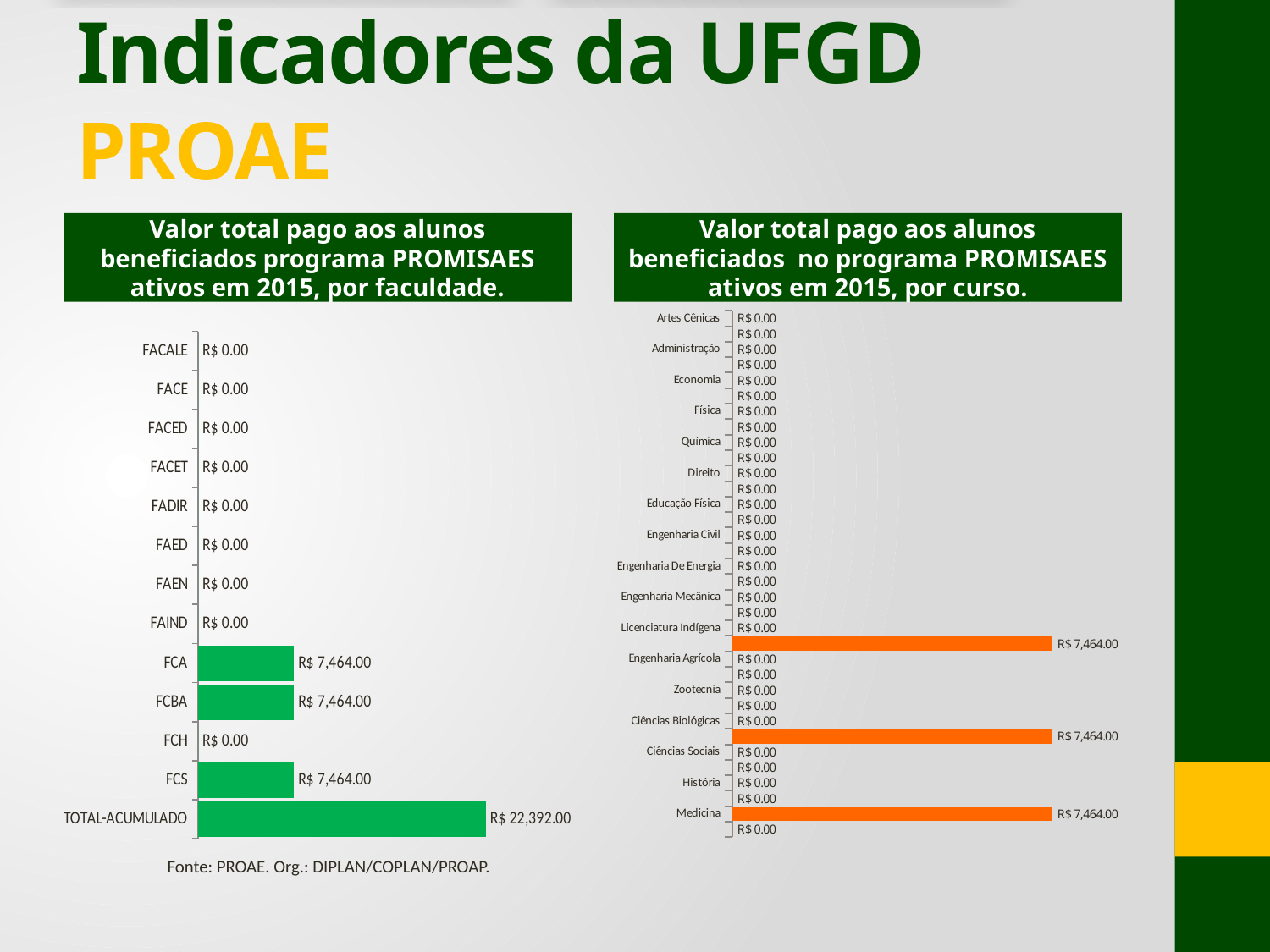
On the left chart (por faculdade), what is the value for FACALE? R$ 0.00 On the left chart (por faculdade), how many faculties (excluding TOTAL-ACUMULADO) have a value of R$ 7,464.00? 3 On the left chart (por faculdade), how many categories are shown? 13 On the right chart (por curso), what is the value for Artes Cênicas? R$ 0.00 On the left chart (por faculdade), what is the difference between TOTAL-ACUMULADO and FCS? R$ 14,928.00 On the right chart (por curso), how many bars show a value of R$ 7,464.00? 3 What colour are the bars on the right chart (por curso)? Orange On the left chart (por faculdade), which is larger, the value for FCBA or the value for FCH? FCBA On the left chart (por faculdade), what is the value for FCA? R$ 7,464.00 On the left chart (por faculdade), which category has the highest value? TOTAL-ACUMULADO On the left chart (por faculdade), what is the value for TOTAL-ACUMULADO? R$ 22,392.00 What type of chart is the left chart (por faculdade)? Bar chart